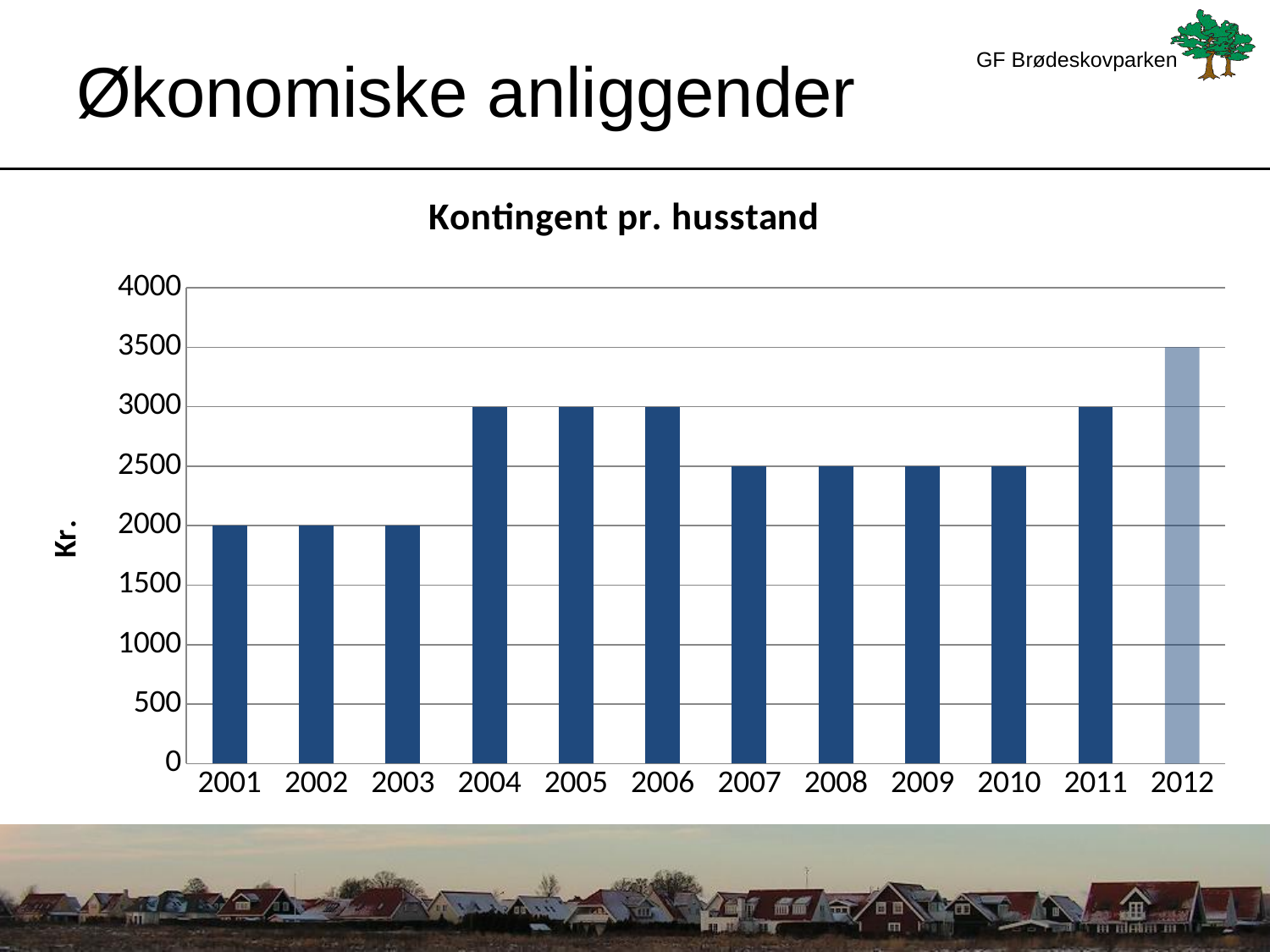
Is the value for 2009 greater or less than 3000? less What kind of chart is shown on the slide? bar chart What is the difference between the values for 2012 and 2011? 500 How many years are shown on the x axis? 12 Which is larger, the value for 2006 or the value for 2007? 2006 What is the value for 2008? 2500 Which year has the highest value? 2012 What is the value for 2005? 3000 What is the value for 2001? 2000 What is the title of the chart? Kontingent pr. husstand What is the difference between the values for 2004 and 2003? 1000 What is the value for 2012 in the Kontingent pr. husstand chart? 3500